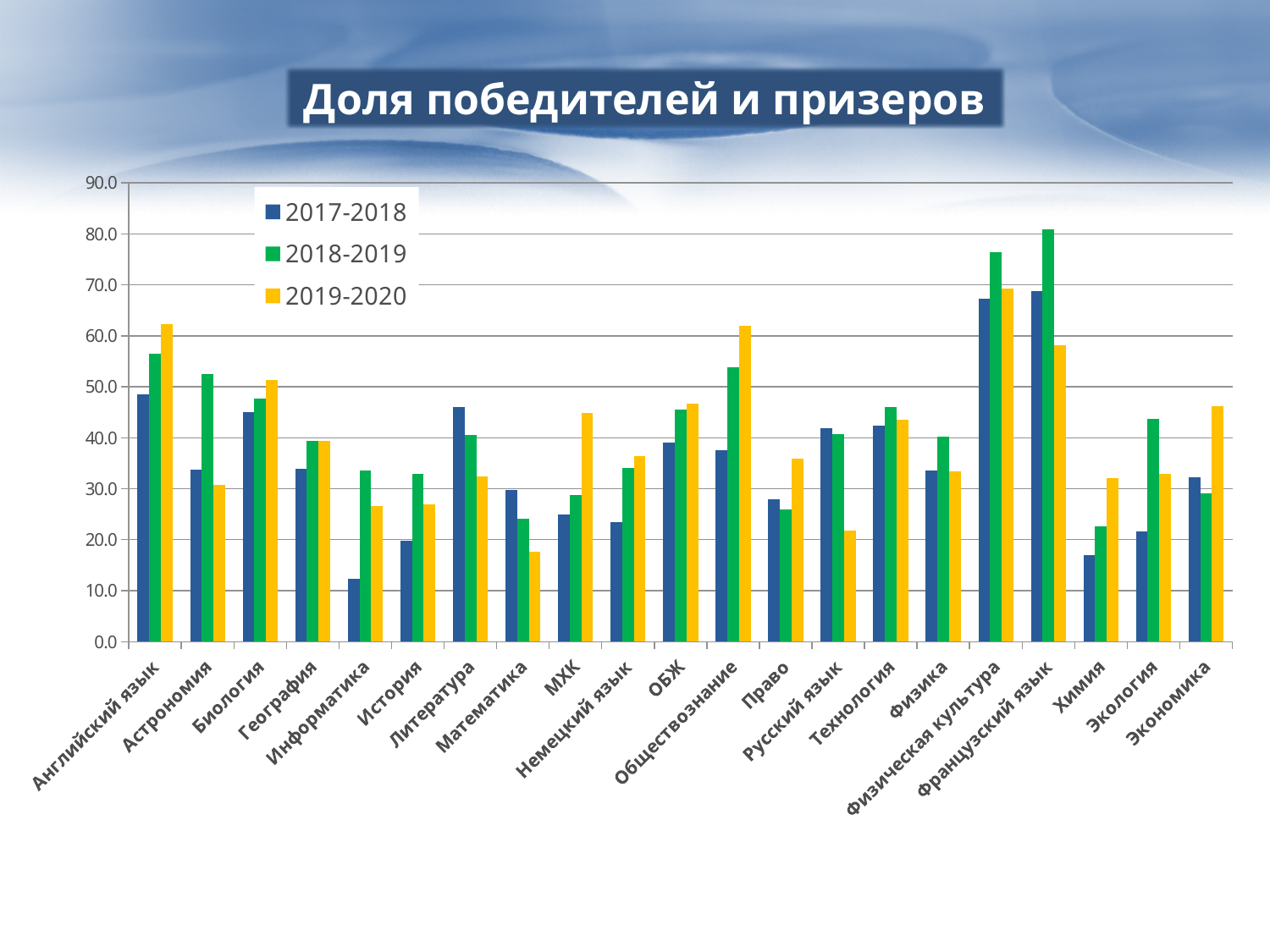
What is the title of the chart? Доля победителей и призеров For Английский язык, which series has the larger value: 2017-2018 or 2019-2020? 2019-2020 Which subject has the highest value for the 2018-2019 series? Французский язык Is the 2018-2019 value for Французский язык greater or less than 80? greater Is the 2017-2018 value for Информатика greater or less than 20? less Which subject has the lowest value for the 2017-2018 series? Информатика How many series does the legend list? 3 How many subject categories are shown on the x axis? 21 Is the 2019-2020 value for Обществознание greater or less than 60? greater What kind of chart is shown on the slide? Bar chart Which subject has the highest value for the 2019-2020 series? Физическая культура For Литература, which series has the larger value: 2017-2018 or 2018-2019? 2017-2018